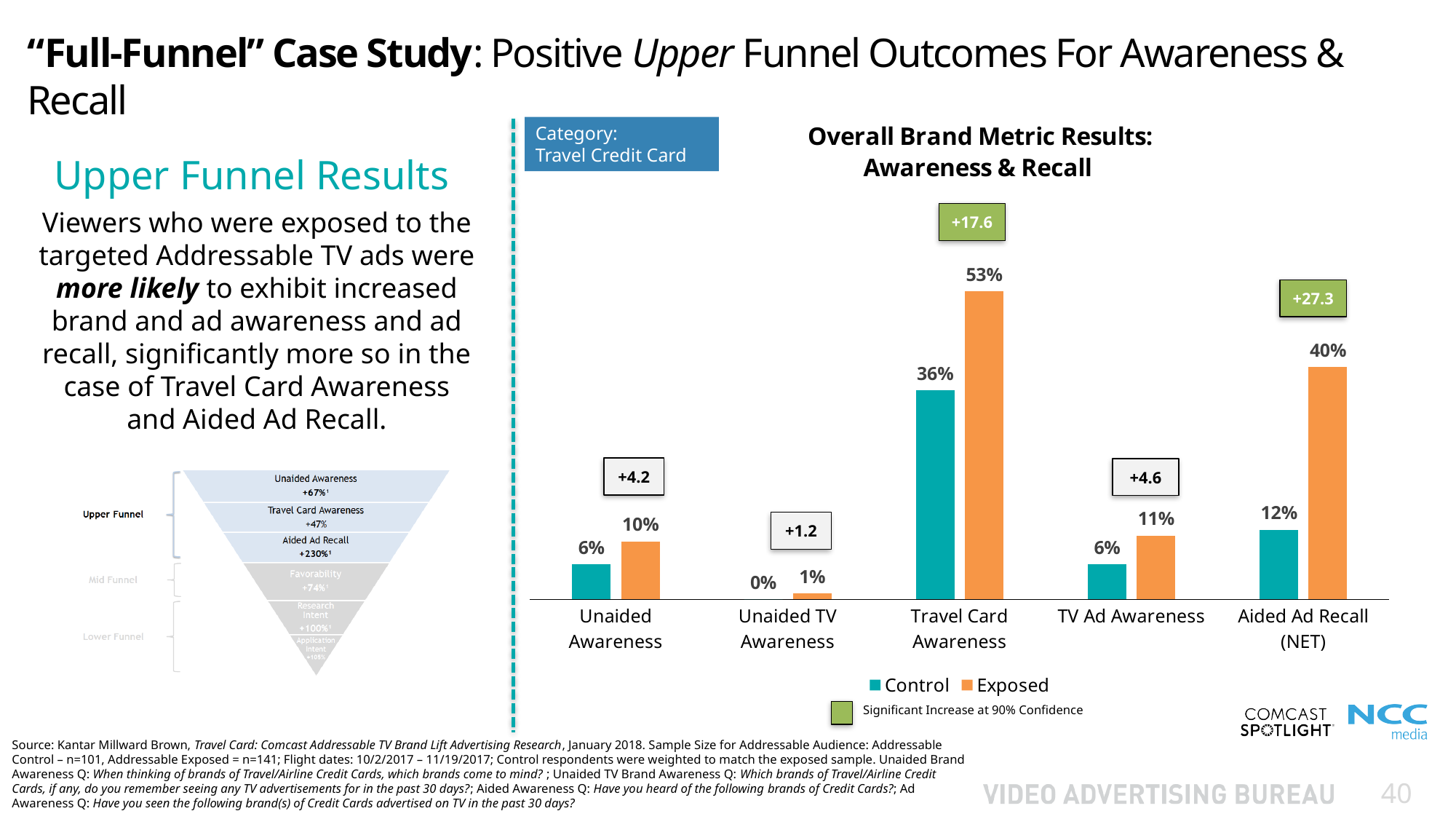
How many series does the legend of the "Overall Brand Metric Results: Awareness & Recall" chart list? 2 In the "Overall Brand Metric Results: Awareness & Recall" chart, what lift value is shown in the green box above Travel Card Awareness? +17.6 In the "Overall Brand Metric Results: Awareness & Recall" chart, which is larger: the Control value for Travel Card Awareness or the Exposed value for Aided Ad Recall (NET)? Exposed value for Aided Ad Recall (NET) What kind of chart is the "Overall Brand Metric Results: Awareness & Recall" chart? Bar chart In the "Overall Brand Metric Results: Awareness & Recall" chart, which category has the highest Exposed value? Travel Card Awareness How many categories are shown on the x axis of the "Overall Brand Metric Results: Awareness & Recall" chart? 5 In the "Overall Brand Metric Results: Awareness & Recall" chart, what is the difference between the Exposed and Control values for Unaided Awareness? 4% In the "Overall Brand Metric Results: Awareness & Recall" chart, what is the Exposed value for Travel Card Awareness? 53% In the "Overall Brand Metric Results: Awareness & Recall" chart, what is the difference between the Exposed and Control values for Aided Ad Recall (NET)? 28% In the "Overall Brand Metric Results: Awareness & Recall" chart, what is the Exposed value for TV Ad Awareness? 11% In the "Overall Brand Metric Results: Awareness & Recall" chart, which category has the lowest Control value? Unaided TV Awareness In the "Overall Brand Metric Results: Awareness & Recall" chart, what is the Control value for Aided Ad Recall (NET)? 12%